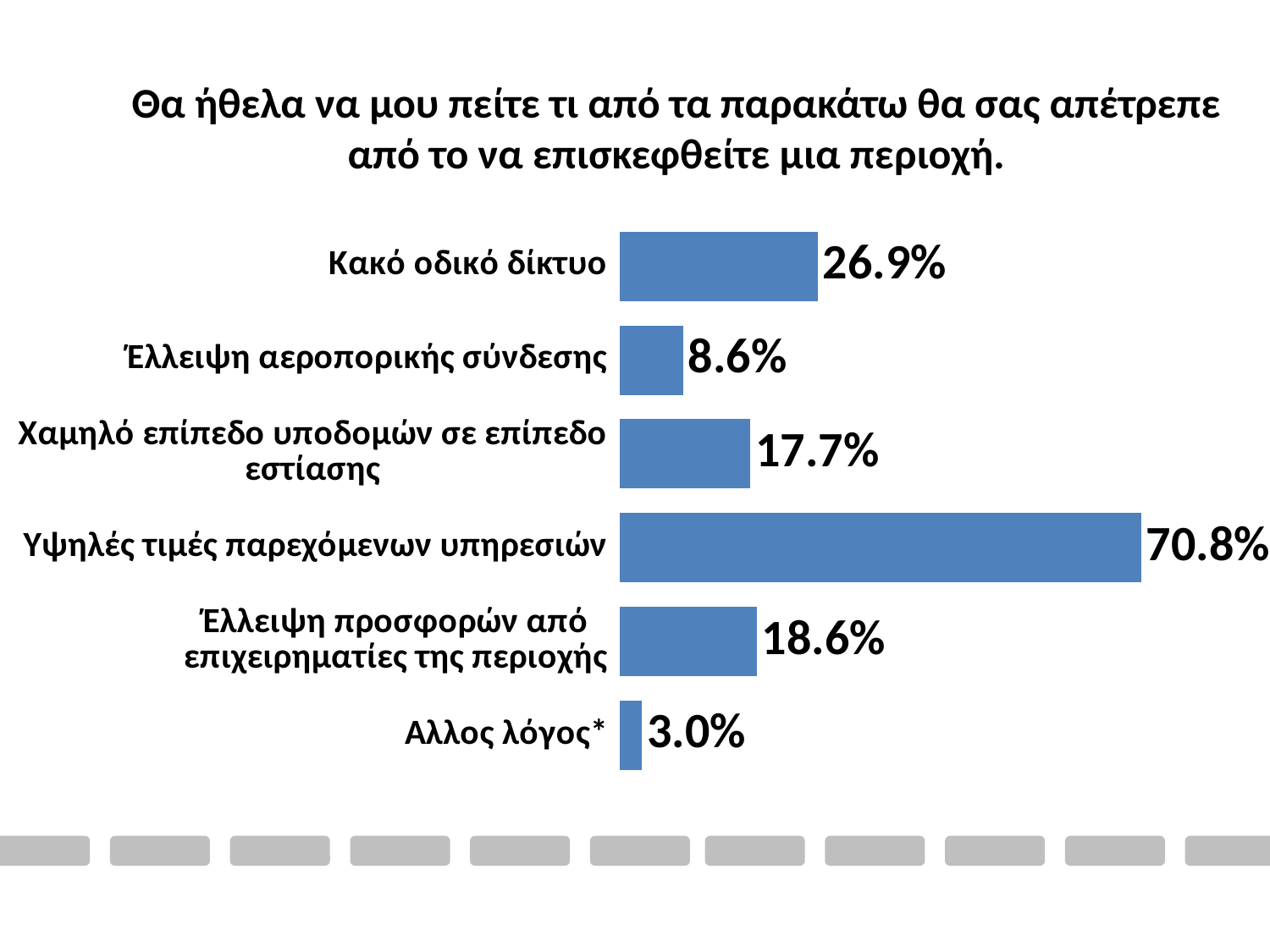
Which category has the highest value? Υψηλές τιμές παρεχόμενων υπηρεσιών How many categories are shown in the chart? 6 Which is larger, the value for Κακό οδικό δίκτυο or the value for Έλλειψη προσφορών από επιχειρηματίες της περιοχής? Κακό οδικό δίκτυο What is the value for Άλλος λόγος*? 3.0% What is the value for Έλλειψη αεροπορικής σύνδεσης? 8.6% What is the difference between the values for Έλλειψη προσφορών από επιχειρηματίες της περιοχής and Χαμηλό επίπεδο υποδομών σε επίπεδο εστίασης? 0.9% What kind of chart is shown on the slide? Bar chart Which category has the lowest value? Άλλος λόγος* What colour are the bars in the chart? Blue What is the value for Κακό οδικό δίκτυο? 26.9% What is the value for Υψηλές τιμές παρεχόμενων υπηρεσιών? 70.8% What is the difference between the values for Υψηλές τιμές παρεχόμενων υπηρεσιών and Κακό οδικό δίκτυο? 43.9%